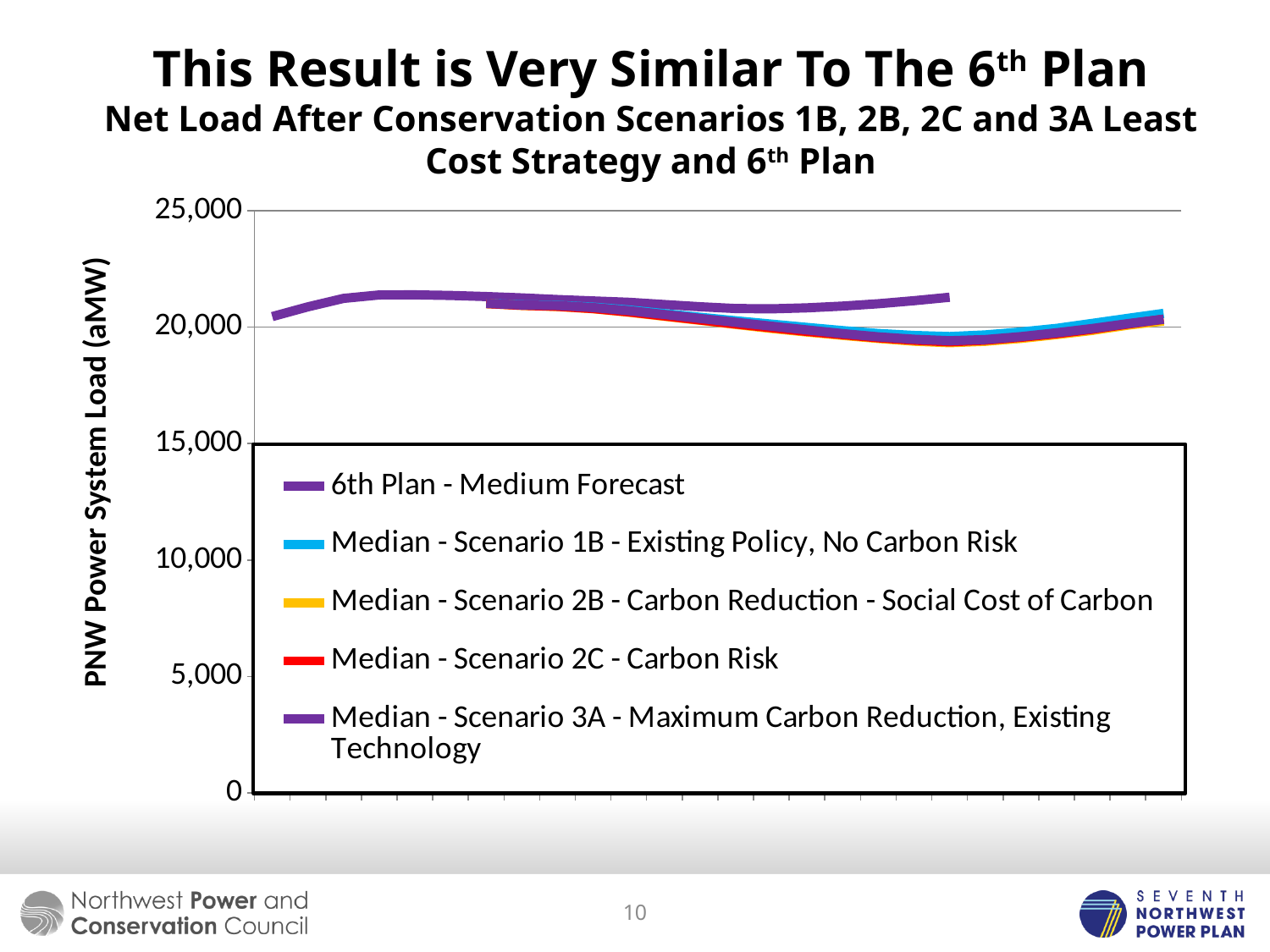
Is the lowest point of the Median - Scenario 1B - Existing Policy, No Carbon Risk line greater or less than 15,000? greater How many series does the legend list? 5 Is the highest point of the 6th Plan - Medium Forecast line greater or less than 25,000? less What kind of chart is shown on the slide? Line chart Do the Median scenario lines fall or rise in the middle portion of the chart before turning up at the end? fall Over the period where both are plotted, which line is higher: 6th Plan - Medium Forecast or Median - Scenario 2C - Carbon Risk? 6th Plan - Medium Forecast Which series in the legend is drawn in red? Median - Scenario 2C - Carbon Risk What is the highest value shown on the vertical axis? 25,000 Is the lowest point of the Median - Scenario 2C - Carbon Risk line greater or less than 20,000? less What is the label of the vertical axis? PNW Power System Load (aMW)